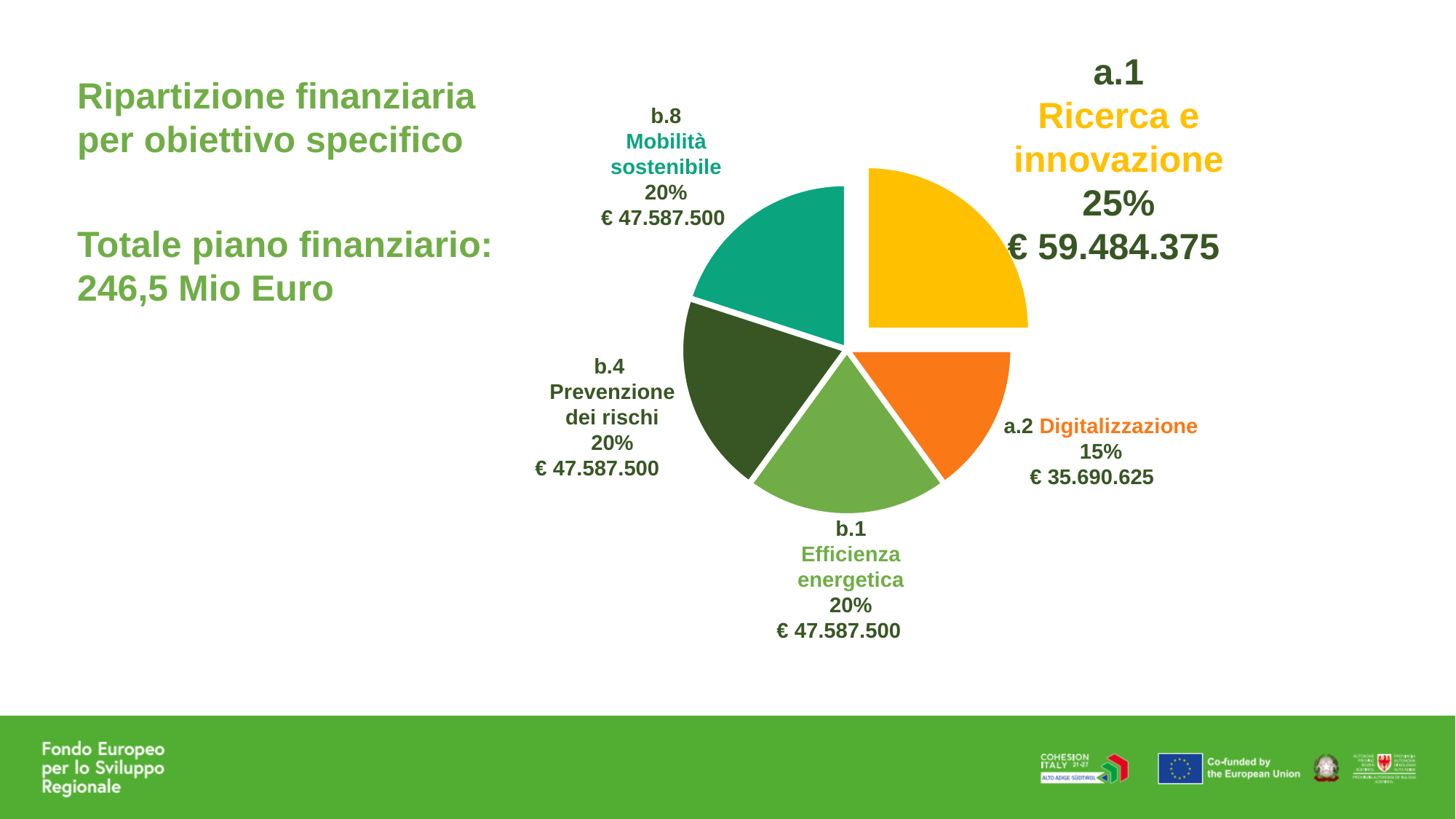
What is the difference in percentage points between a.1 Ricerca e innovazione and b.4 Prevenzione dei rischi? 5% What kind of chart is shown on the slide? pie chart Which specific objective has the smallest slice of the pie? a.2 Digitalizzazione Which is larger, the share for b.1 Efficienza energetica or the share for a.2 Digitalizzazione? b.1 Efficienza energetica Which specific objective has the largest slice of the pie? a.1 Ricerca e innovazione What is the amount shown for b.8 Mobilità sostenibile? € 47.587.500 What is the amount shown for a.2 Digitalizzazione? € 35.690.625 What share of the pie does a.2 Digitalizzazione represent? 15% What is the difference in amount between a.1 Ricerca e innovazione and a.2 Digitalizzazione? € 23.793.750 What is the title of the chart on the slide? Ripartizione finanziaria per obiettivo specifico How many slices does the pie chart have? 5 What share of the pie does a.1 Ricerca e innovazione represent? 25%